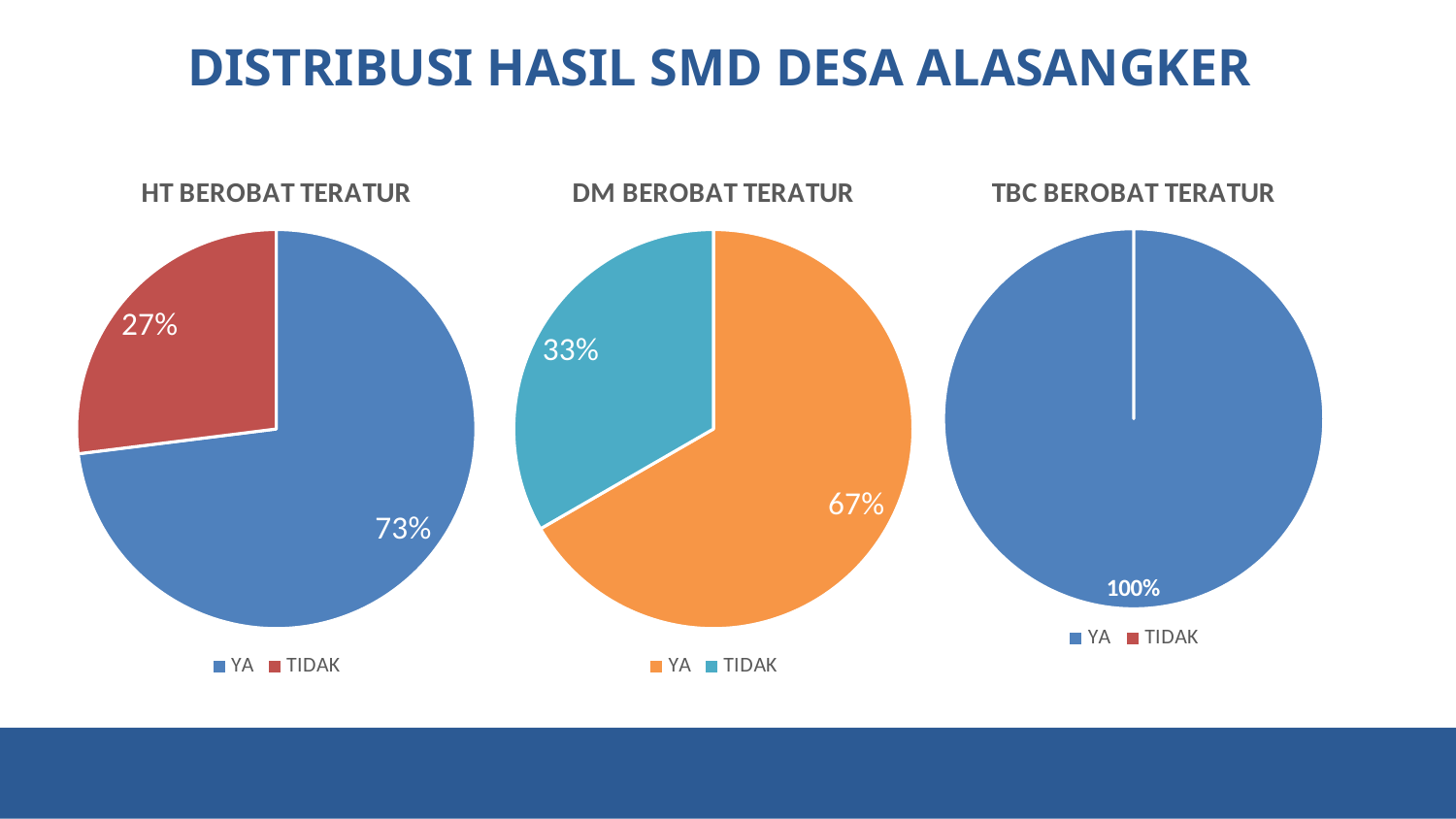
In the 'HT BEROBAT TERATUR' chart, what share of the pie is 'YA'? 73% How many entries does the legend of the 'DM BEROBAT TERATUR' chart list? 2 In the 'DM BEROBAT TERATUR' chart, which slice is the smallest? TIDAK In the 'DM BEROBAT TERATUR' chart, which is larger, 'YA' or 'TIDAK'? YA In the 'DM BEROBAT TERATUR' chart, what share of the pie is 'TIDAK'? 33% In the 'TBC BEROBAT TERATUR' chart, what share of the pie is 'YA'? 100% What kind of chart is 'TBC BEROBAT TERATUR'? Pie chart In the 'HT BEROBAT TERATUR' chart, what is the difference between the 'YA' and 'TIDAK' shares? 46% What is the title of the slide containing the three charts? DISTRIBUSI HASIL SMD DESA ALASANGKER In the 'HT BEROBAT TERATUR' chart, which slice is the largest? YA